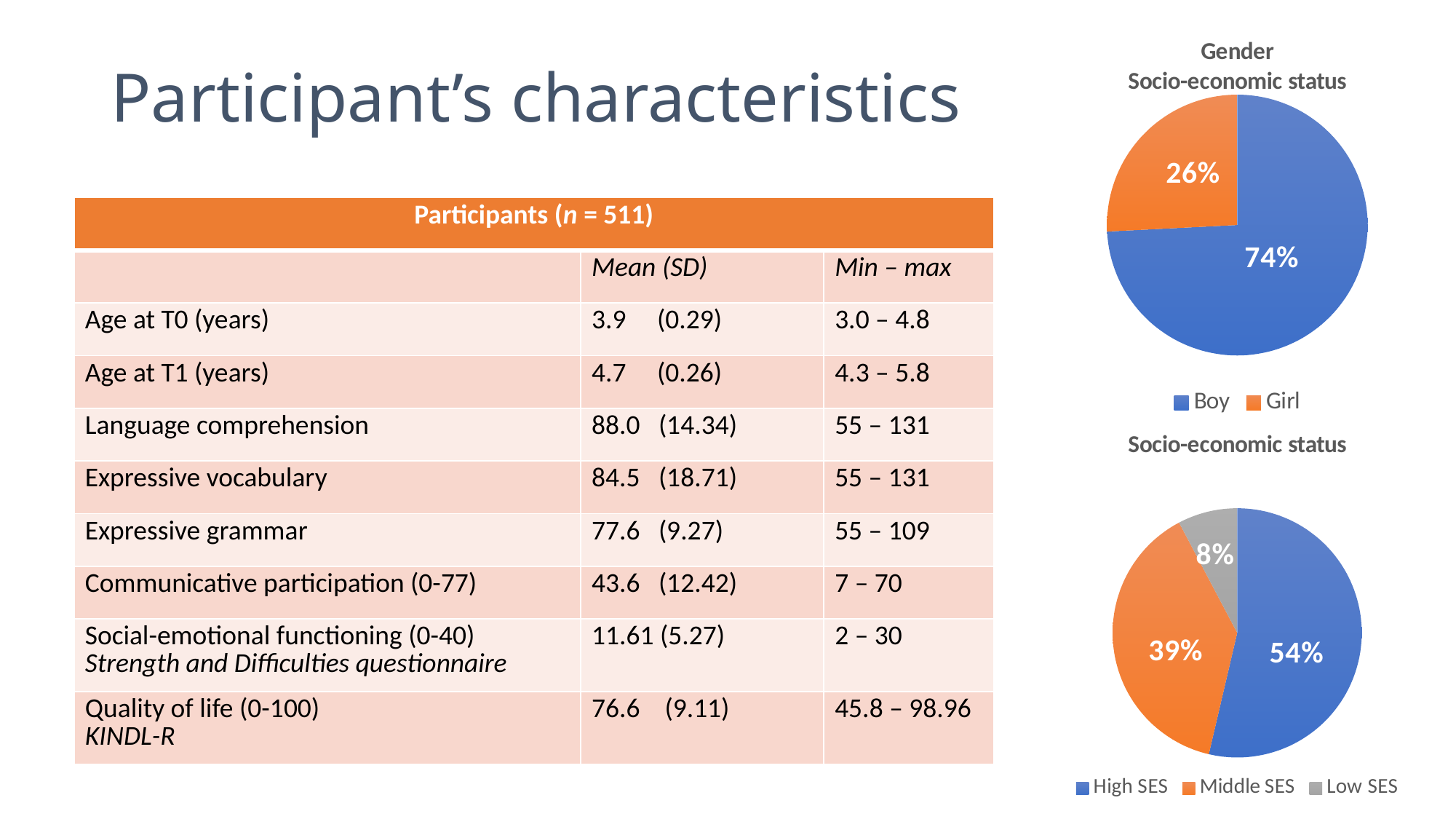
In the Socio-economic status pie chart, how many categories does the legend list? 3 In the Socio-economic status pie chart, what share of participants are Middle SES? 39% What type of chart is the Gender chart? Pie chart In the Gender pie chart, what is the difference in percentage points between the Boy and Girl slices? 48 In the Gender pie chart, what share of participants are girls? 26% In the Gender pie chart, which category has the larger slice? Boy In the Socio-economic status pie chart, which category has the smallest slice? Low SES In the Socio-economic status pie chart, what share of participants are Low SES? 8% In the Gender pie chart, what share of participants are boys? 74% In the Socio-economic status pie chart, what colour is the Middle SES slice? Orange In the Socio-economic status pie chart, which category has the largest slice? High SES In the Socio-economic status pie chart, what share of participants are High SES? 54%